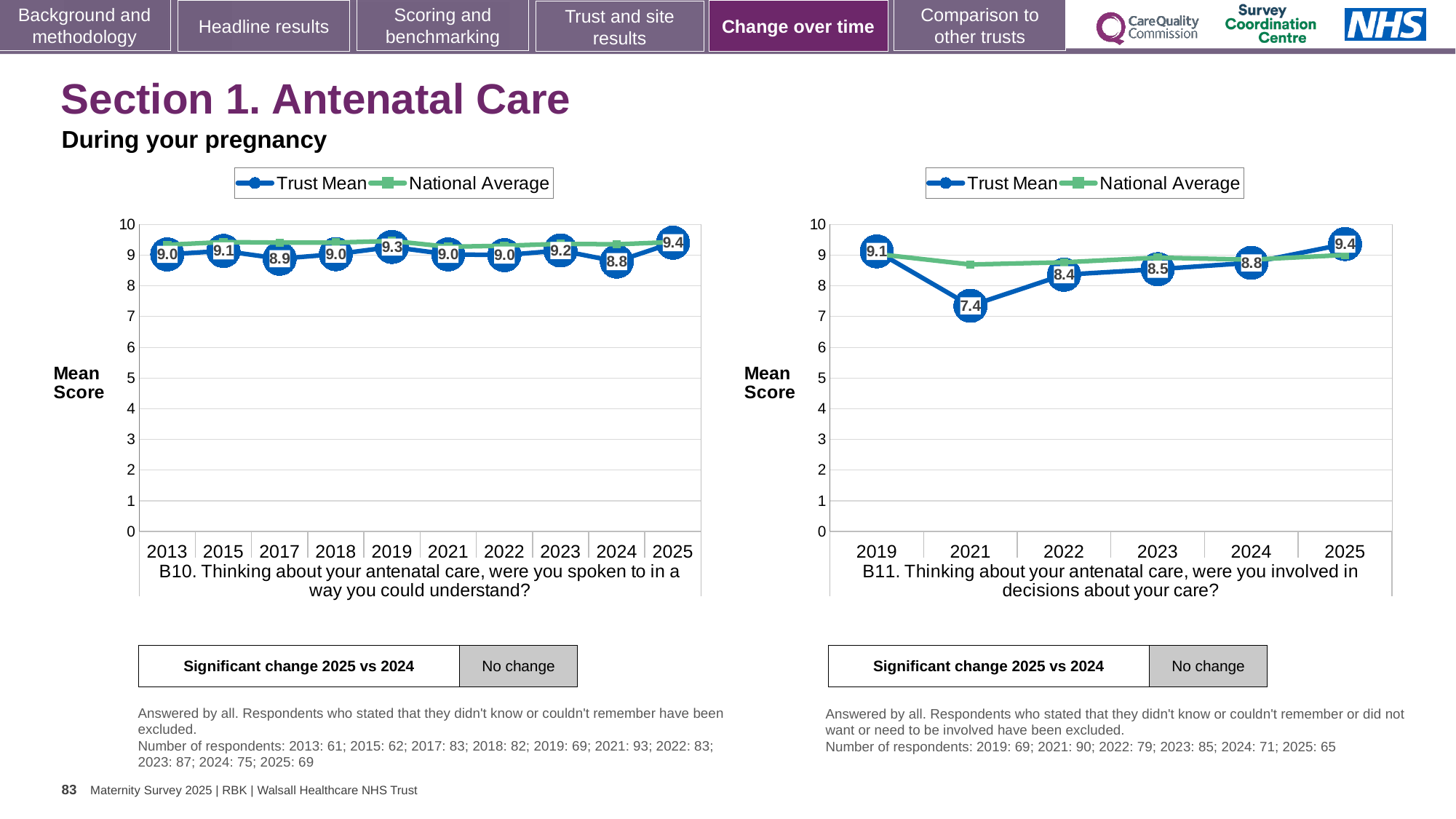
In the B11 chart on the right, which year has the lowest Trust Mean score? 2021 What kind of chart is the B10 chart on the left? line chart In the B10 chart on the left, which year has the lowest Trust Mean score? 2024 In the B11 chart on the right, does the Trust Mean rise or fall from 2021 to 2025? rise How many series does the legend of the B11 chart on the right list? 2 In the B10 chart on the left, what is the difference between the Trust Mean scores for 2025 and 2024? 0.6 In the B11 chart on the right, which year has the highest Trust Mean score? 2025 In the B11 chart on the right, what is the Trust Mean score for 2021? 7.4 In the B10 chart on the left, how many years are shown on the x axis? 10 In the B11 chart on the right, what is the difference between the Trust Mean scores for 2019 and 2021? 1.7 In the B10 chart on the left, what is the Trust Mean score for 2025? 9.4 In the B10 chart on the left, what is the Trust Mean score for 2024? 8.8